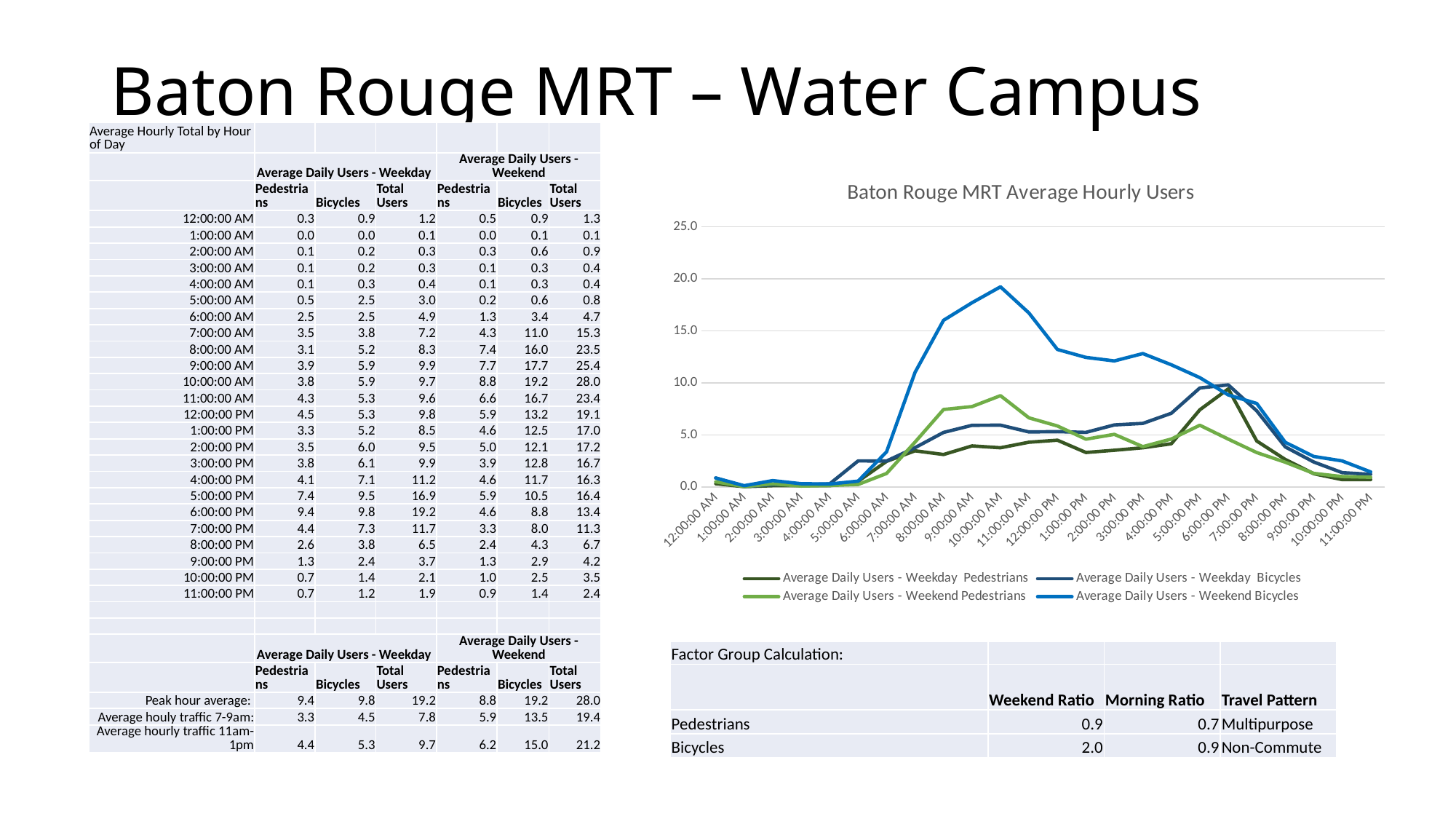
Does the Weekend Bicycles line rise or fall from 10:00:00 AM to 11:00:00 PM? Falls How many hourly points are plotted along the x axis of the chart? 24 Which series reaches the highest value on the chart? Average Daily Users - Weekend Bicycles Is the value for Weekday Pedestrians at 6:00:00 PM greater or less than 5.0? greater What kind of chart is shown on the slide? Line chart At which hour does the Weekend Bicycles line reach its peak? 10:00:00 AM How many series does the chart's legend list? 4 Is the value for Weekend Pedestrians at 10:00:00 AM greater or less than 10.0? less At 6:00:00 PM, which is larger: Weekday Pedestrians or Weekend Pedestrians? Weekday Pedestrians Is the value for Weekend Bicycles at 10:00:00 AM greater or less than 15.0? greater What is the title of the chart? Baton Rouge MRT Average Hourly Users At 8:00:00 AM, which is larger: Weekend Bicycles or Weekday Bicycles? Weekend Bicycles